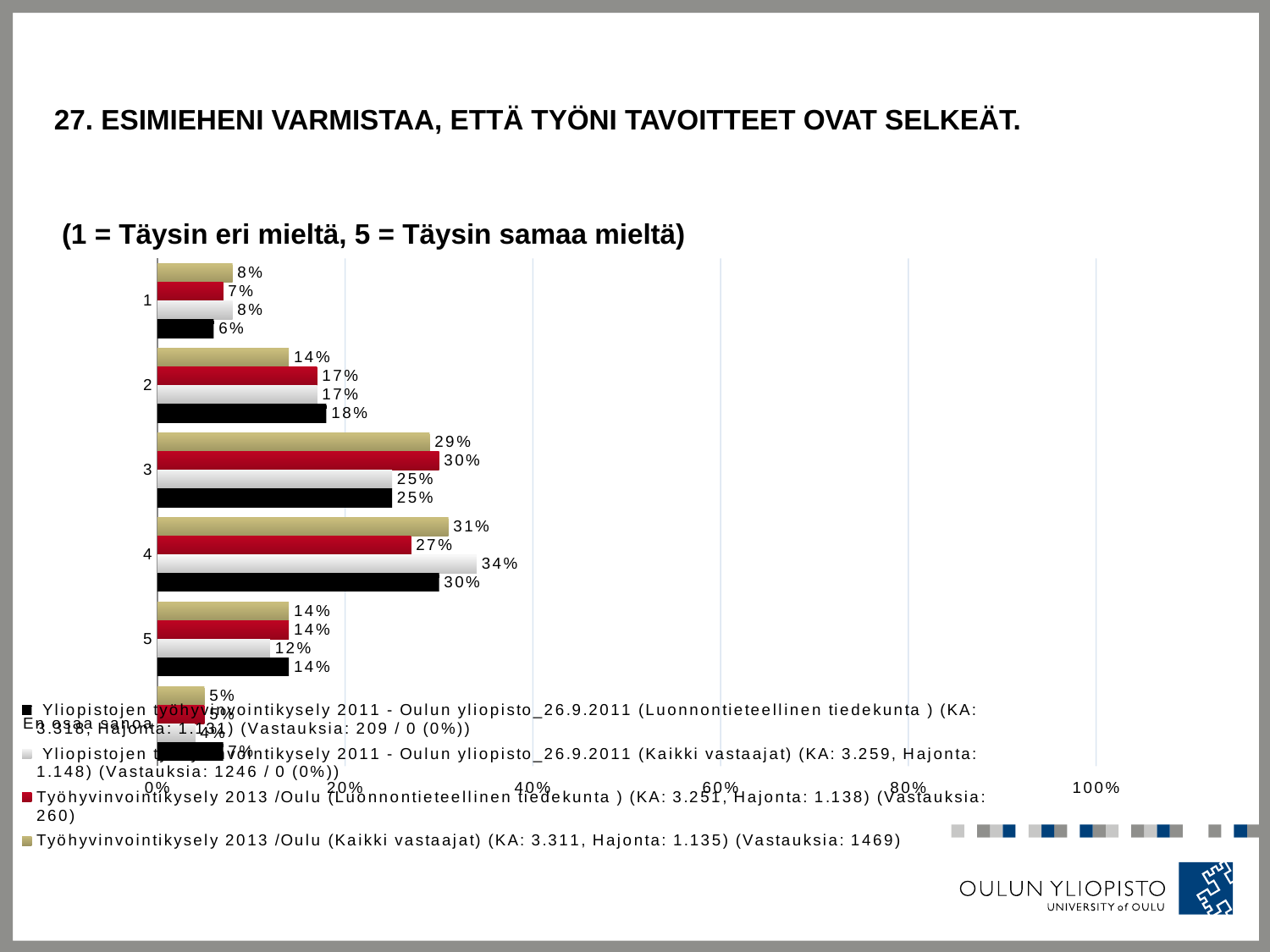
What is the value of the black bar (2011, Luonnontieteellinen tiedekunta) for category 2? 18% What is the difference between the light gray bar (34%) and the red bar (27%) for category 4? 7% What is the title of the chart on the slide? 27. ESIMIEHENI VARMISTAA, ETTÄ TYÖNI TAVOITTEET OVAT SELKEÄT. For the black series (2011, Luonnontieteellinen tiedekunta), which of the categories 1 to 5 has the lowest value? 1 How many series does the legend list? 4 What is the value of the light gray bar (2011, Kaikki vastaajat) for category 4? 34% What is the value of the gold bar (Työhyvinvointikysely 2013 /Oulu, Kaikki vastaajat) for category 4? 31% What kind of chart is shown on the slide? bar chart For the gold series (2013, Kaikki vastaajat), which of the categories 1 to 5 has the highest value? 4 For category 3, which is larger: the red bar (2013, Luonnontieteellinen tiedekunta) or the light gray bar (2011, Kaikki vastaajat)? the red bar (30%) Is the value of the black bar for category 4 greater or less than 20%? greater What is the value of the red bar (2013, Luonnontieteellinen tiedekunta) for category 3? 30%